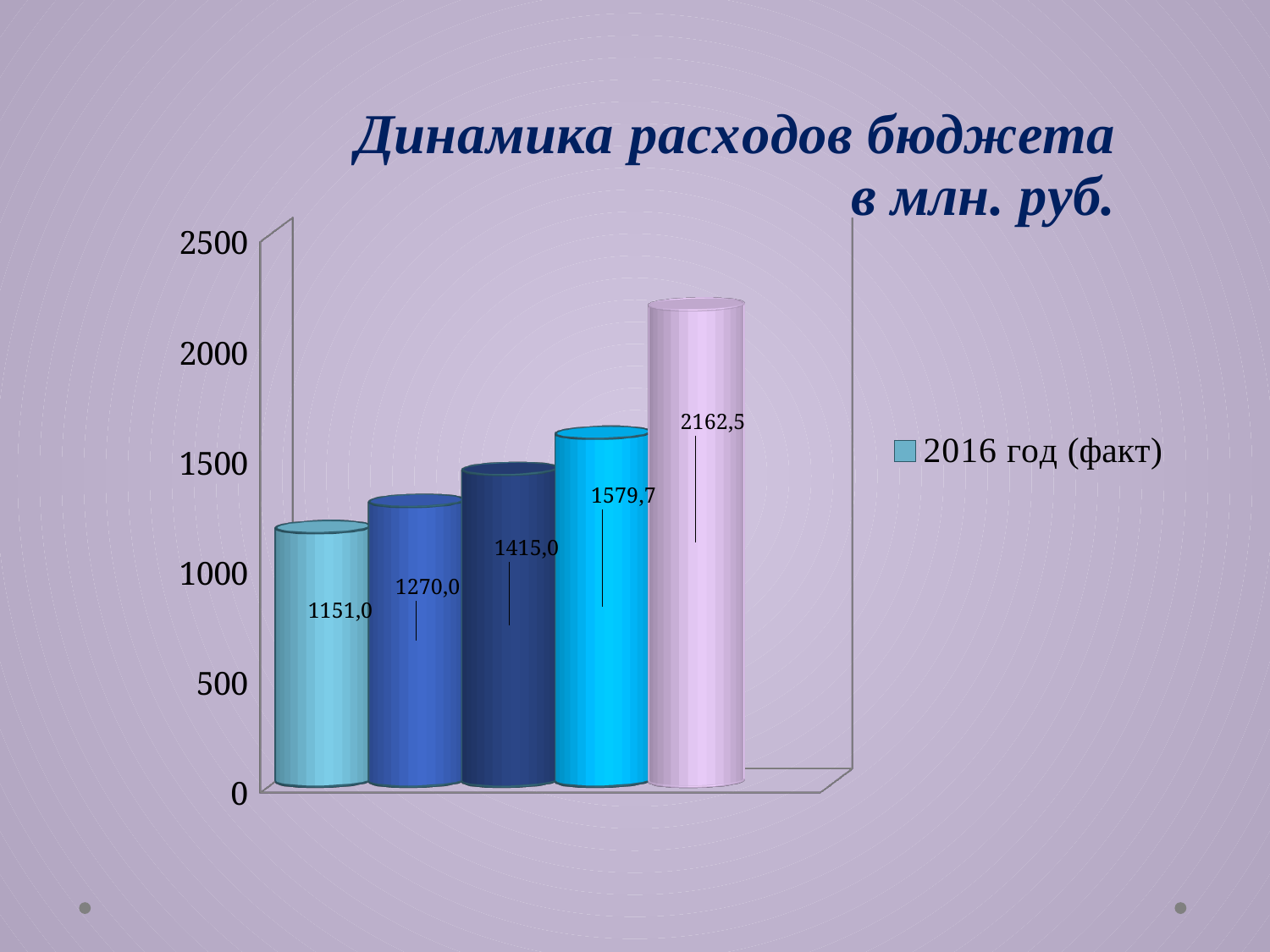
Do the bar values rise or fall from left to right? rise What is the value labelled on the rightmost (light pink) bar? 2162,5 What type of chart is shown on the slide? bar chart What is the title of the chart? Динамика расходов бюджета в млн. руб. Which bar has the lowest value? the leftmost bar (1151,0) What is the value labelled on the leftmost bar? 1151,0 What is the legend entry shown next to the chart? 2016 год (факт) Which bar has the highest value? the rightmost bar (2162,5) What is the value labelled on the third bar from the left (dark navy)? 1415,0 How many entries does the legend list? 1 How many bars are plotted in the chart? 5 What is the difference between the rightmost bar (2162,5) and the fourth bar (1579,7)? 582,8